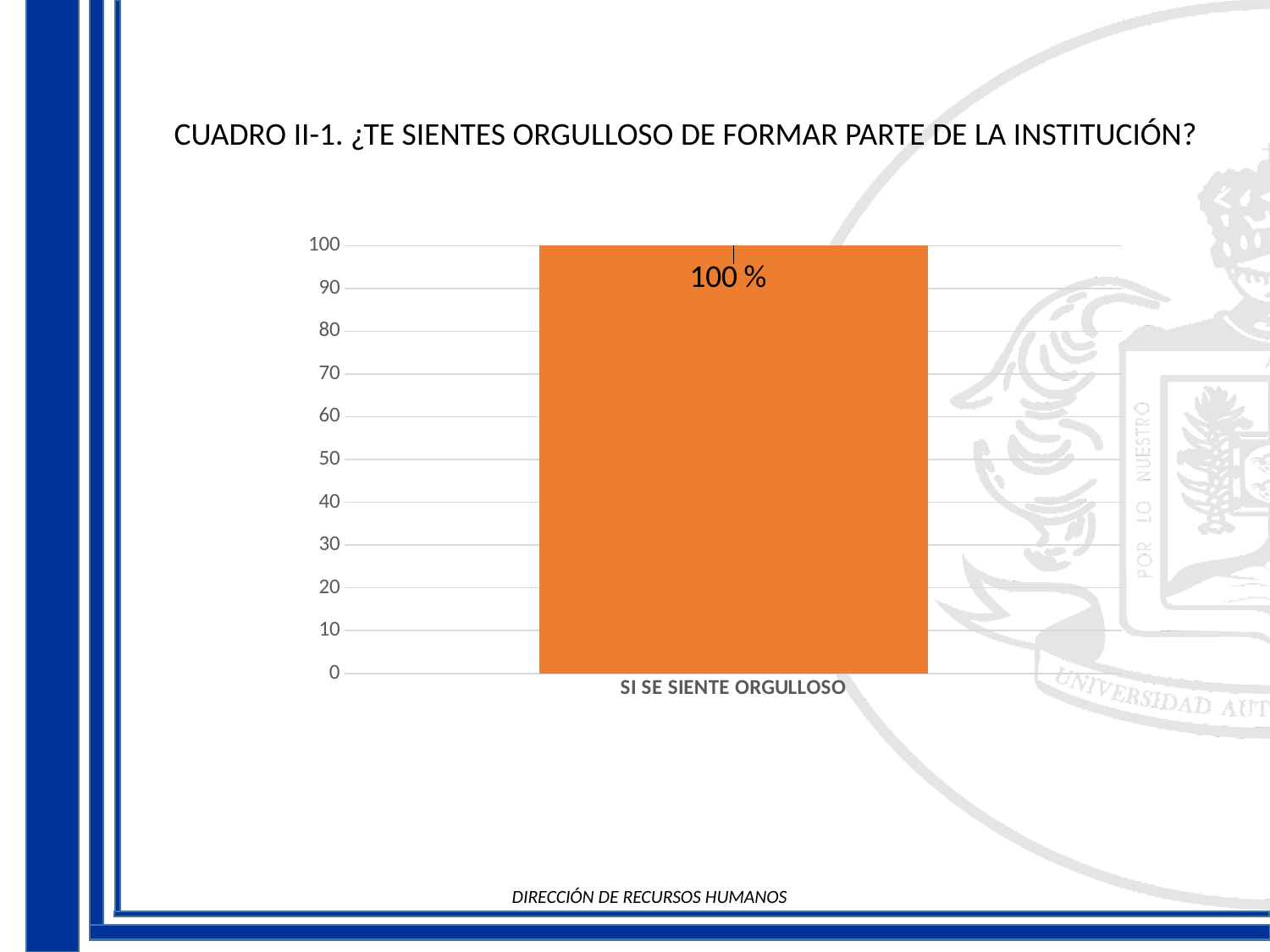
What is the label of the single category on the x axis? SI SE SIENTE ORGULLOSO How many categories are plotted on the x axis? 1 What kind of chart is shown on the slide? bar chart What colour is the bar in the chart? orange What is the highest value shown on the vertical axis? 100 Is the value for SI SE SIENTE ORGULLOSO greater or less than 50? greater What is the value shown for SI SE SIENTE ORGULLOSO? 100 %